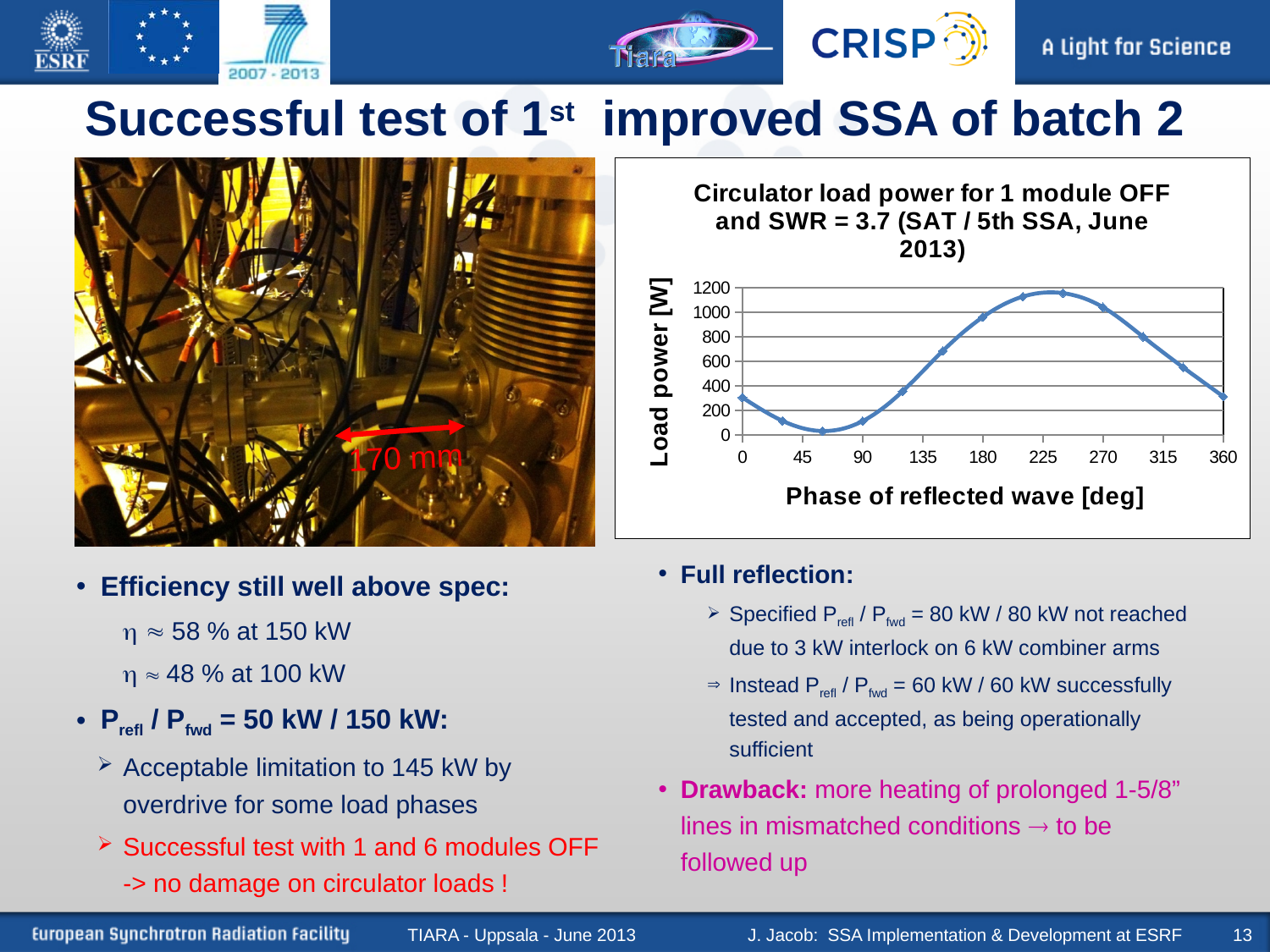
What is the label of the y axis of the chart? Load power [W] Does the load power rise or fall as the phase goes from 90 deg to 225 deg? rise What kind of chart is shown on the slide? line chart Is the load power at a phase of 90 deg greater or less than 200? less Does the load power rise or fall as the phase goes from 0 deg to 60 deg? fall Is the load power at a phase of 0 deg greater or less than 400? less How many data points are plotted on the curve? 13 What is the title of the chart? Circulator load power for 1 module OFF and SWR = 3.7 (SAT / 5th SSA, June 2013) Is the load power at a phase of 180 deg greater or less than 800? greater Which is larger, the load power at 180 deg or at 90 deg? 180 deg What is the highest tick value shown on the y axis? 1200